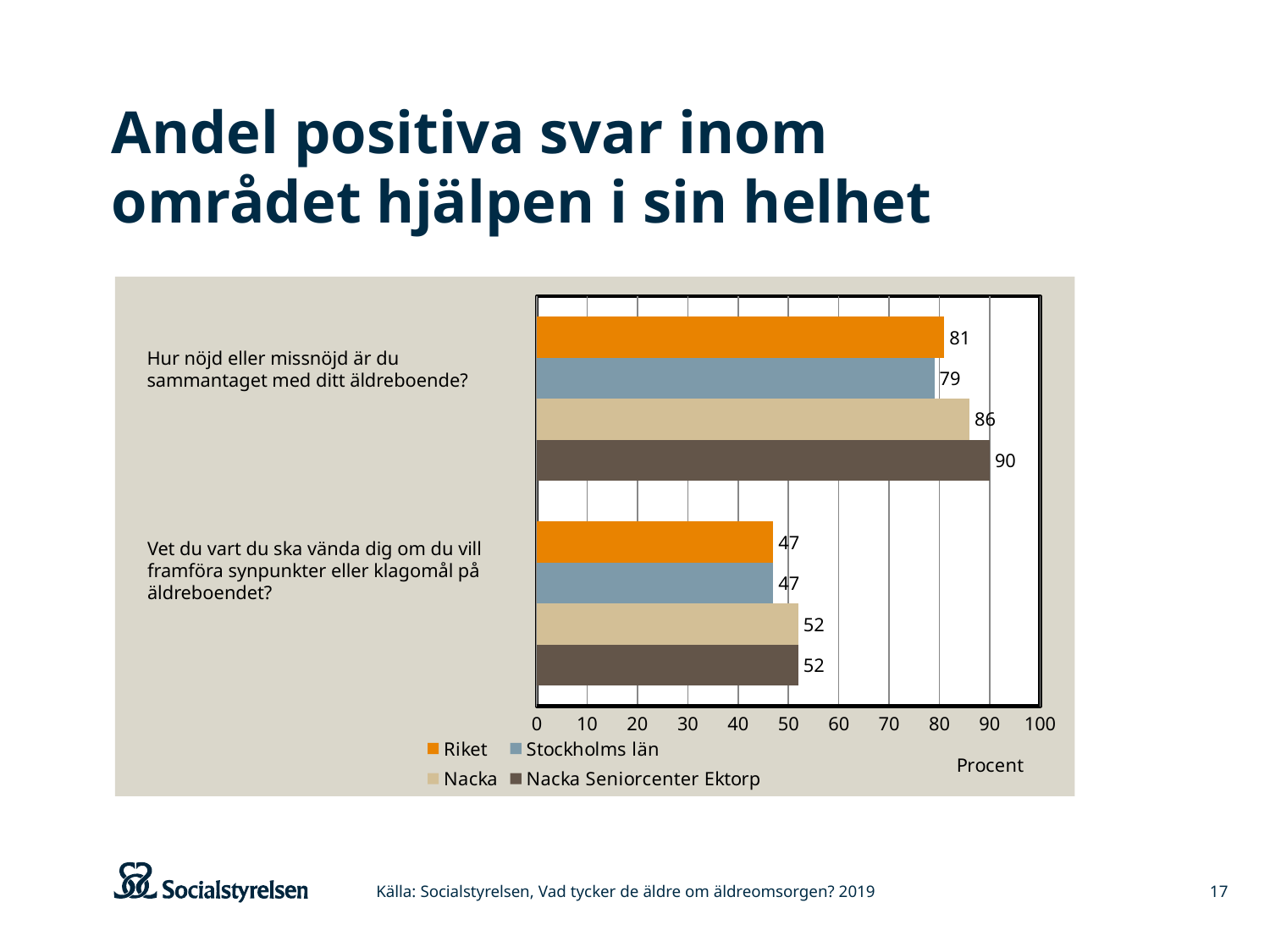
What value does Riket have for the question 'Vet du vart du ska vända dig om du vill framföra synpunkter eller klagomål på äldreboendet?' 47 Is the Nacka Seniorcenter Ektorp value for the question 'Vet du vart du ska vända dig om du vill framföra synpunkter eller klagomål på äldreboendet?' greater or less than 60? less What value does Stockholms län have for the question 'Hur nöjd eller missnöjd är du sammantaget med ditt äldreboende?' 79 What kind of chart is shown on the slide? bar chart Which series has the highest value for the question 'Hur nöjd eller missnöjd är du sammantaget med ditt äldreboende?' Nacka Seniorcenter Ektorp What is the difference between the Nacka value and the Stockholms län value for the question 'Vet du vart du ska vända dig om du vill framföra synpunkter eller klagomål på äldreboendet?' 5 For the question 'Hur nöjd eller missnöjd är du sammantaget med ditt äldreboende?', which is larger: the Nacka value or the Riket value? Nacka What is the difference between the Nacka Seniorcenter Ektorp value and the Riket value for the question 'Hur nöjd eller missnöjd är du sammantaget med ditt äldreboende?' 9 What value does Nacka Seniorcenter Ektorp have for the question 'Hur nöjd eller missnöjd är du sammantaget med ditt äldreboende?' 90 Which series has the lowest value for the question 'Hur nöjd eller missnöjd är du sammantaget med ditt äldreboende?' Stockholms län How many series does the legend list? 4 What unit is shown on the horizontal axis of the chart? Procent